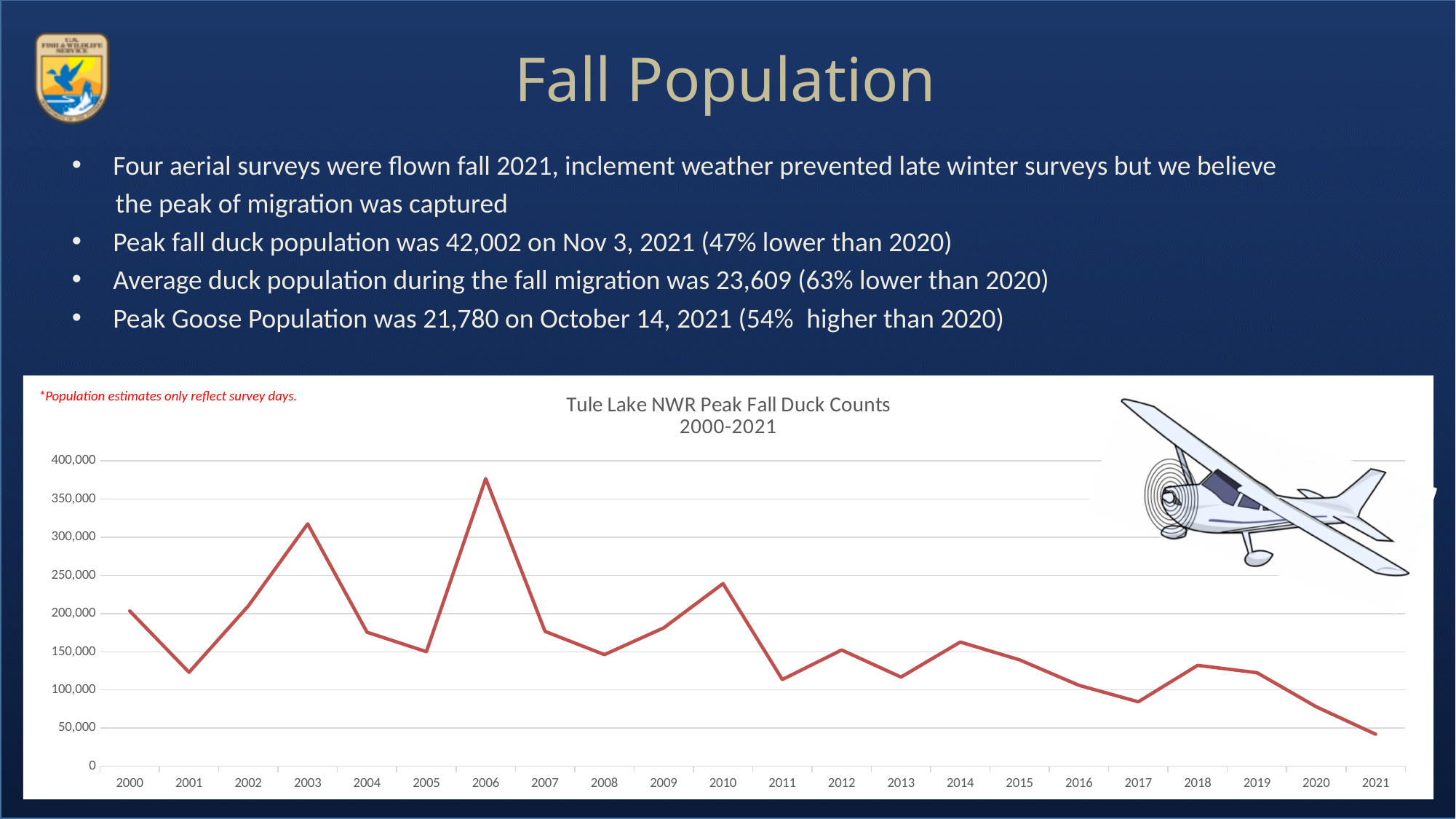
Which year has the larger peak fall duck count, 2013 or 2014? 2014 Is the value for 2003 greater or less than 300,000? greater What is the title of the chart? Tule Lake NWR Peak Fall Duck Counts 2000-2021 Do the values rise or fall from 2018 to 2021? fall Is the value for 2006 greater or less than 350,000? greater Is the value for 2021 greater or less than 50,000? less How many years are plotted on the x axis of the chart? 22 What kind of chart is shown on the slide? line chart Which year has the lowest peak fall duck count? 2021 Which year has the larger peak fall duck count, 2010 or 2011? 2010 Which year has the highest peak fall duck count? 2006